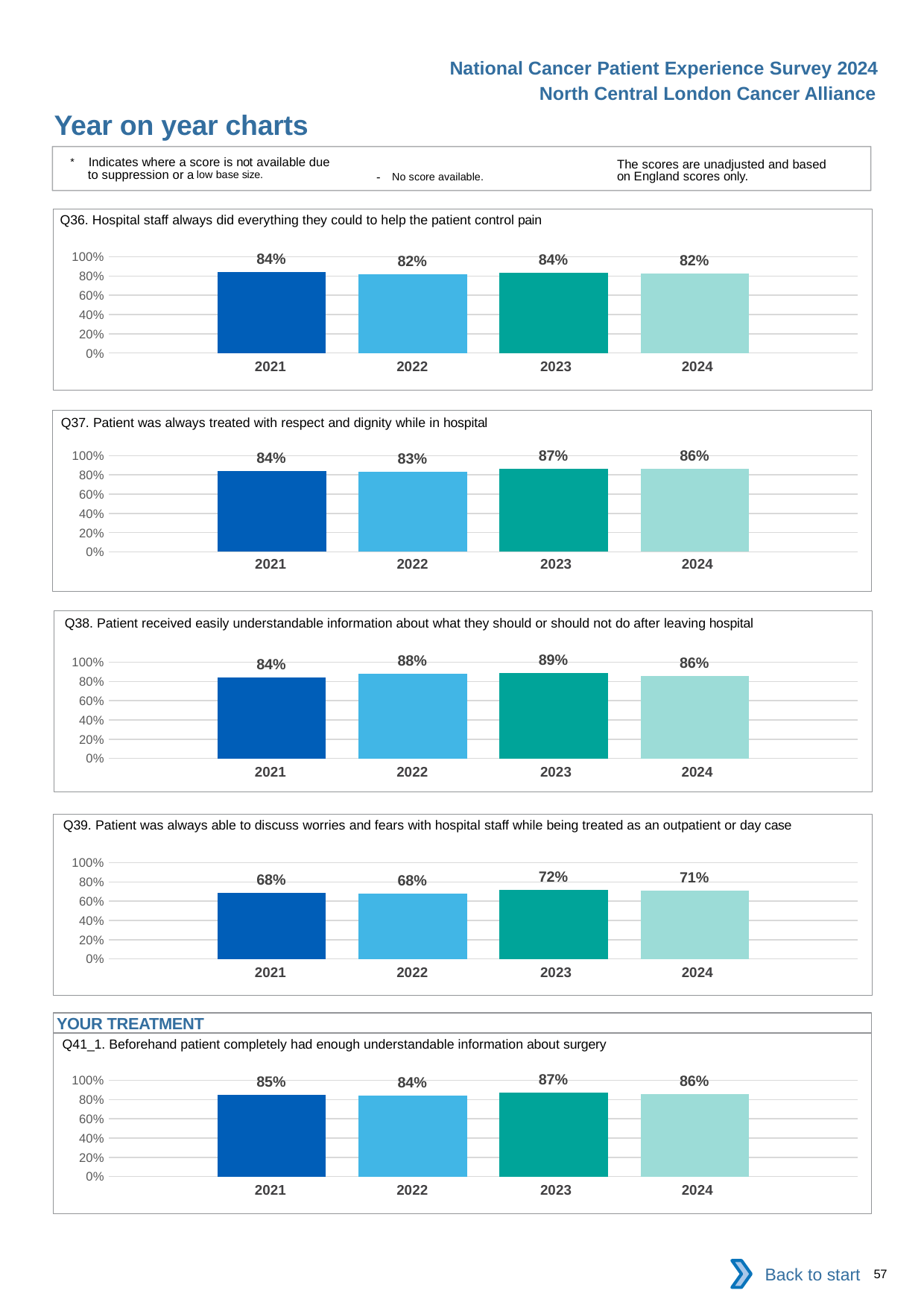
In the Q39 chart (discuss worries and fears as an outpatient), what is the value for 2024? 71% How many years are shown in the Q37 chart? 4 In the Q37 chart (patient treated with respect and dignity), which year has the highest value? 2023 In the Q37 chart, what is the value for 2021? 84% In the Q36 chart (hospital staff did everything to help control pain), what is the value for 2022? 82% In the Q41_1 chart, what is the difference between the 2023 and 2024 values? 1 percentage point In the Q39 chart, which year has the highest value? 2023 What kind of chart is the Q36 chart? bar chart In the Q41_1 chart (understandable information about surgery), which year has the lowest value? 2022 In the Q38 chart, which is larger: the value for 2022 or the value for 2024? 2022 In the Q38 chart (understandable information after leaving hospital), what is the difference between the 2023 and 2021 values? 5 percentage points In the Q39 chart, is the value for 2021 greater or less than 80%? less